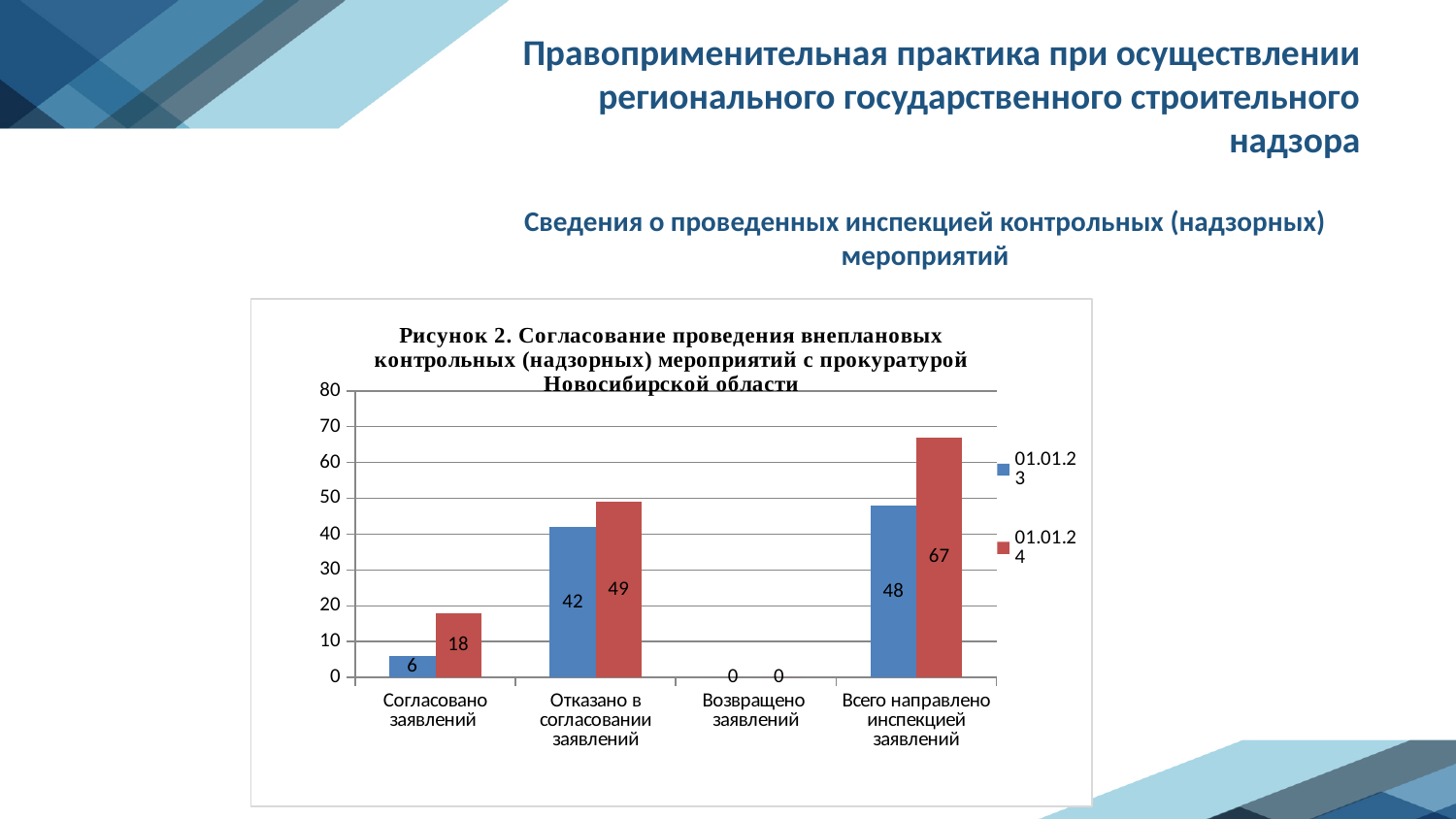
What is the value for 'Согласовано заявлений' in the 01.01.24 series? 18 What is the value for 'Согласовано заявлений' in the 01.01.23 series? 6 Which category has the highest value in the 01.01.24 series? Всего направлено инспекцией заявлений How many series does the legend list? 2 What type of chart is shown on the slide? bar chart What is the difference between the 01.01.24 and 01.01.23 values for 'Всего направлено инспекцией заявлений'? 19 Which is larger for 'Отказано в согласовании заявлений': the 01.01.23 value or the 01.01.24 value? 01.01.24 Which category has the lowest value in the 01.01.23 series? Возвращено заявлений How many categories are shown on the x axis? 4 What is the value for 'Всего направлено инспекцией заявлений' in the 01.01.23 series? 48 What is the value for 'Отказано в согласовании заявлений' in the 01.01.24 series? 49 What is the value for 'Возвращено заявлений' in the 01.01.24 series? 0